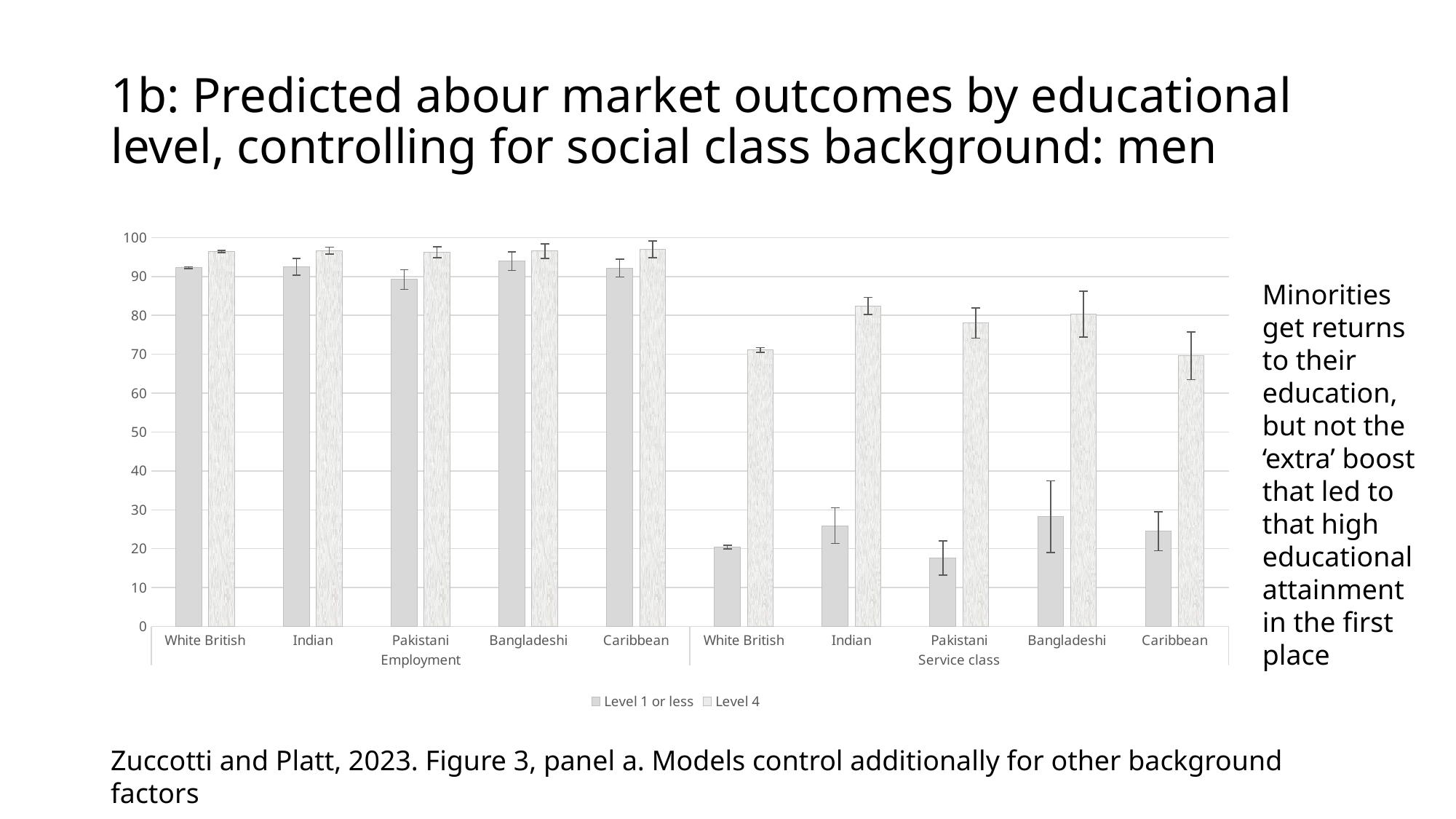
In the Employment group, is the Level 1 or less value for White British greater or less than 90? greater What are the two outcome groups labelled along the x axis? Employment; Service class What type of chart is shown on the slide? bar chart What are the two series named in the legend? Level 1 or less; Level 4 In the Service class group, is the Level 4 value for White British greater or less than 60? greater In the Service class group, is the Level 4 value for Pakistani greater or less than 70? greater In the Service class group, which ethnic group has the lowest Level 1 or less value? Pakistani How many ethnic group categories are shown within the Employment panel of the chart? 5 In the Service class group, which is larger: the Level 4 value for White British or the Level 4 value for Pakistani? Pakistani How many series does the legend list? 2 In the Service class group, which is larger: the Level 4 value for Indian or the Level 4 value for Caribbean? Indian